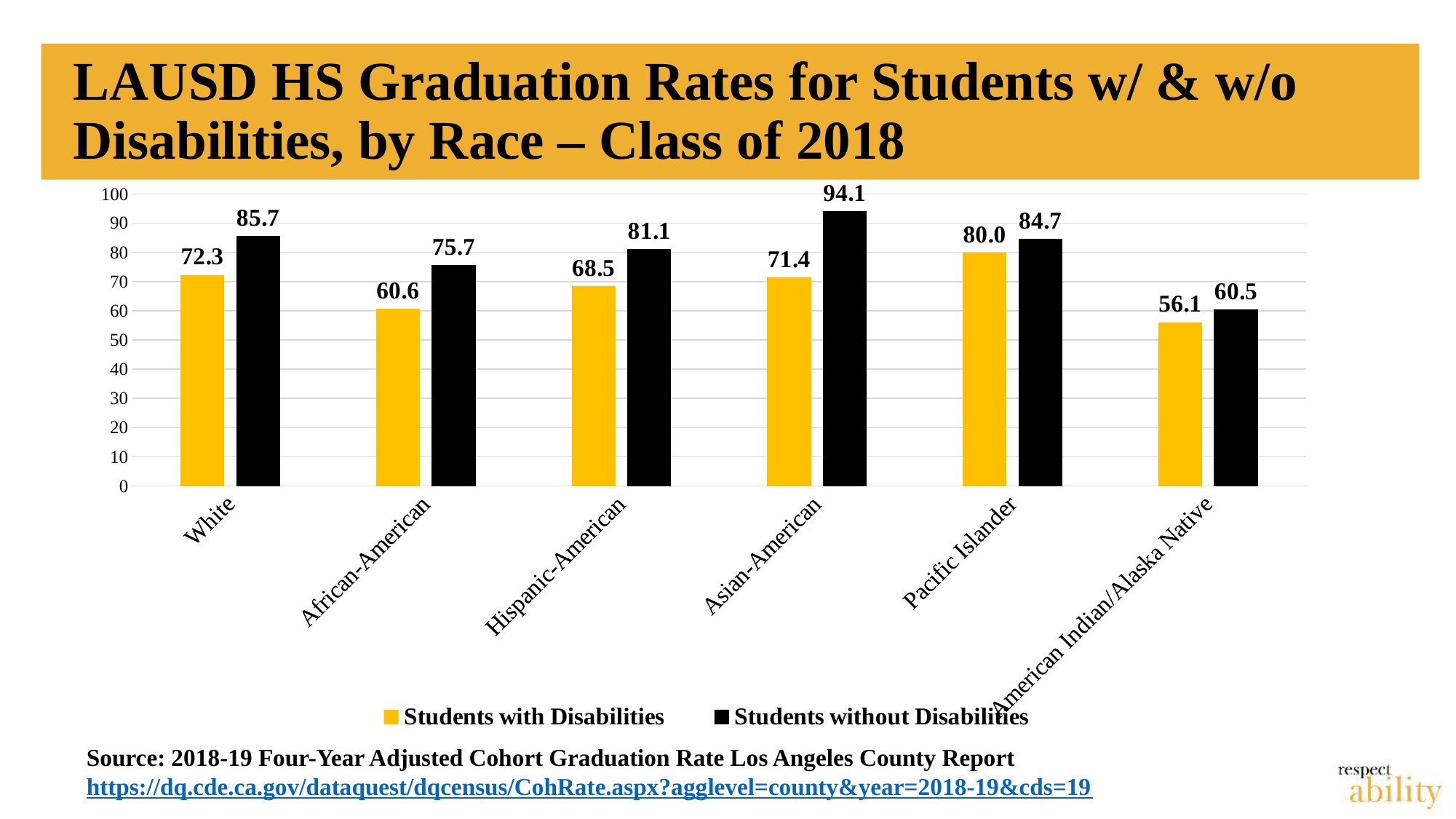
Which is larger: the graduation rate for Hispanic-American students with disabilities or for African-American students with disabilities? Hispanic-American students with disabilities Which colour represents Students with Disabilities in the chart? Yellow How many race categories are shown on the x axis? 6 What kind of chart is shown on the slide? Bar chart What is the graduation rate for American Indian/Alaska Native students with disabilities? 56.1 How many series does the legend list? 2 What is the difference between the graduation rates of Pacific Islander students without disabilities and with disabilities? 4.7 What is the difference between the graduation rates of Asian-American students without disabilities and Asian-American students with disabilities? 22.7 What is the graduation rate for Asian-American students without disabilities? 94.1 Which race category has the lowest graduation rate for students with disabilities? American Indian/Alaska Native Which race category has the highest graduation rate for students without disabilities? Asian-American What is the graduation rate for White students with disabilities? 72.3